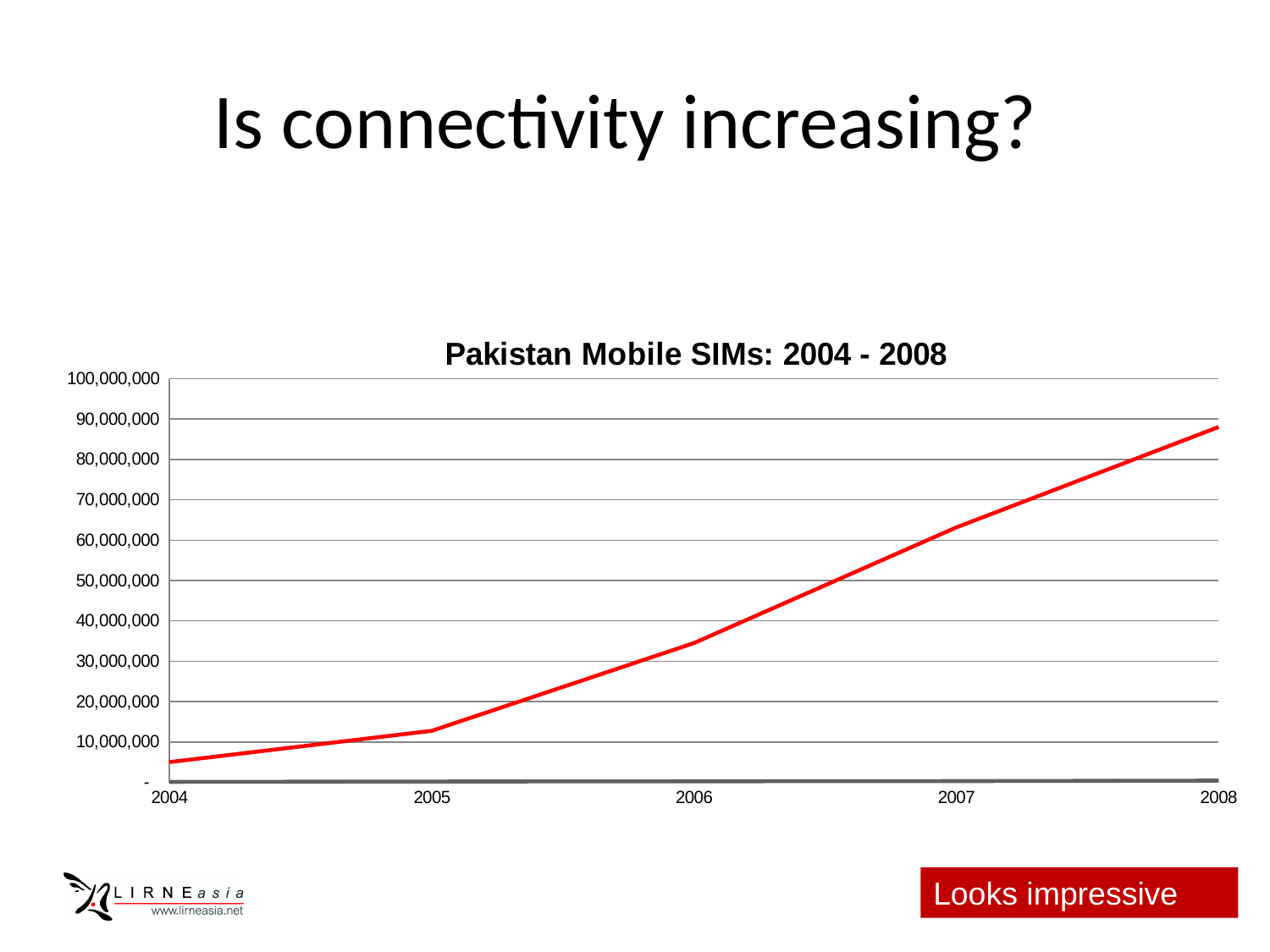
Do the values rise or fall from 2004 to 2008? rise Which is larger, the value for 2007 or the value for 2006? 2007 What colour is the plotted line? red What kind of chart is shown on the slide? line chart Is the value for 2006 greater or less than 30,000,000? greater Which year has the highest value? 2008 Is the value for 2008 greater or less than 90,000,000? less How many data points are plotted on the line? 5 Which year has the lowest value? 2004 Is the value for 2004 greater or less than 10,000,000? less What is the title of the chart? Pakistan Mobile SIMs: 2004 - 2008